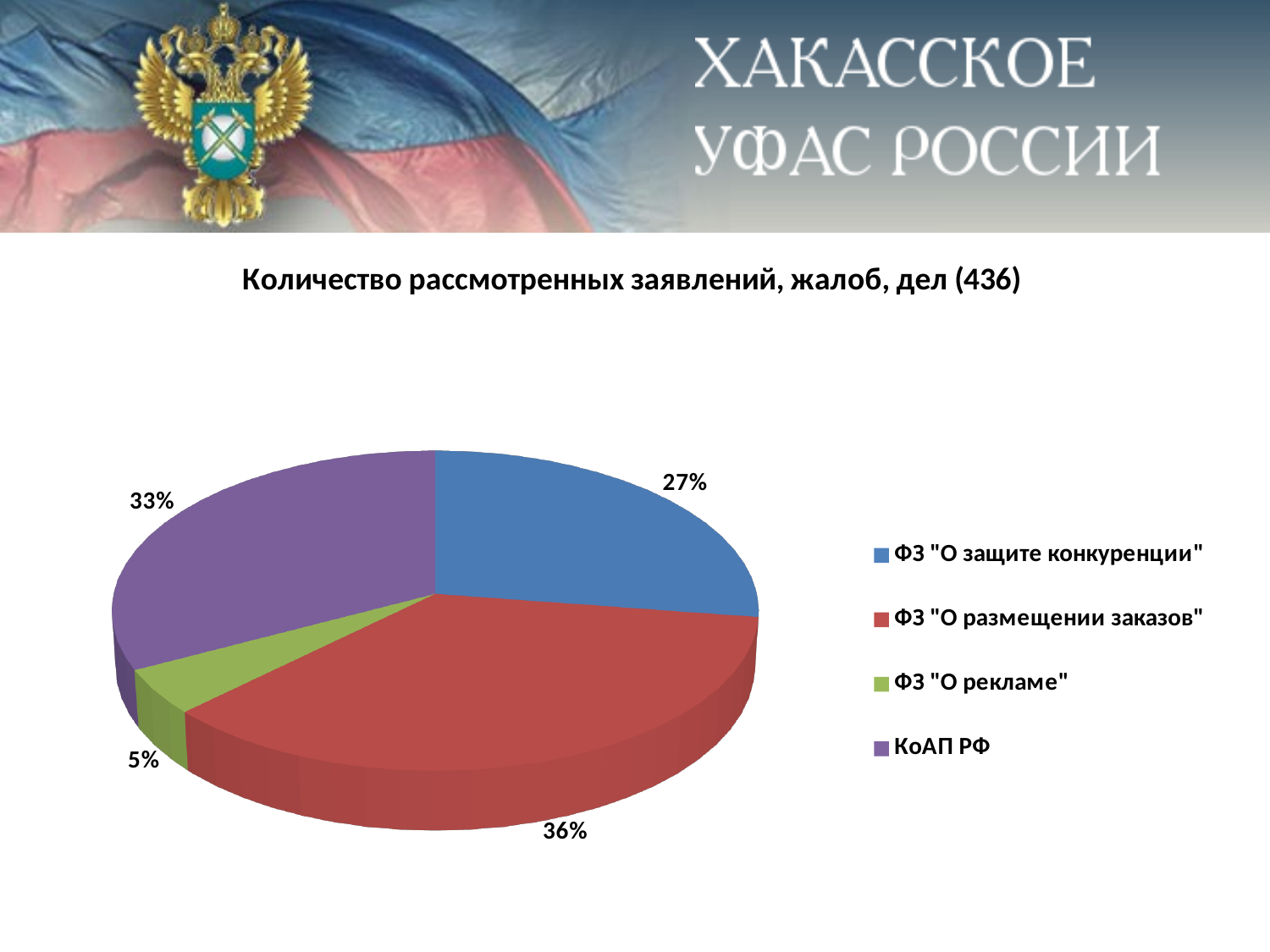
Which category has the largest slice of the pie? ФЗ "О размещении заказов" What is the title of the chart? Количество рассмотренных заявлений, жалоб, дел (436) What is the difference in percentage points between the КоАП РФ slice and the ФЗ "О защите конкуренции" slice? 6 What colour is the slice for КоАП РФ? Purple What share of the pie does ФЗ "О рекламе" account for? 5% Which category has the smallest slice of the pie? ФЗ "О рекламе" How many categories does the pie chart show? 4 What share of the pie does КоАП РФ account for? 33% What share of the pie does ФЗ "О защите конкуренции" account for? 27% What type of chart is shown on the slide? Pie chart Which is larger: the share for КоАП РФ or the share for ФЗ "О защите конкуренции"? КоАП РФ